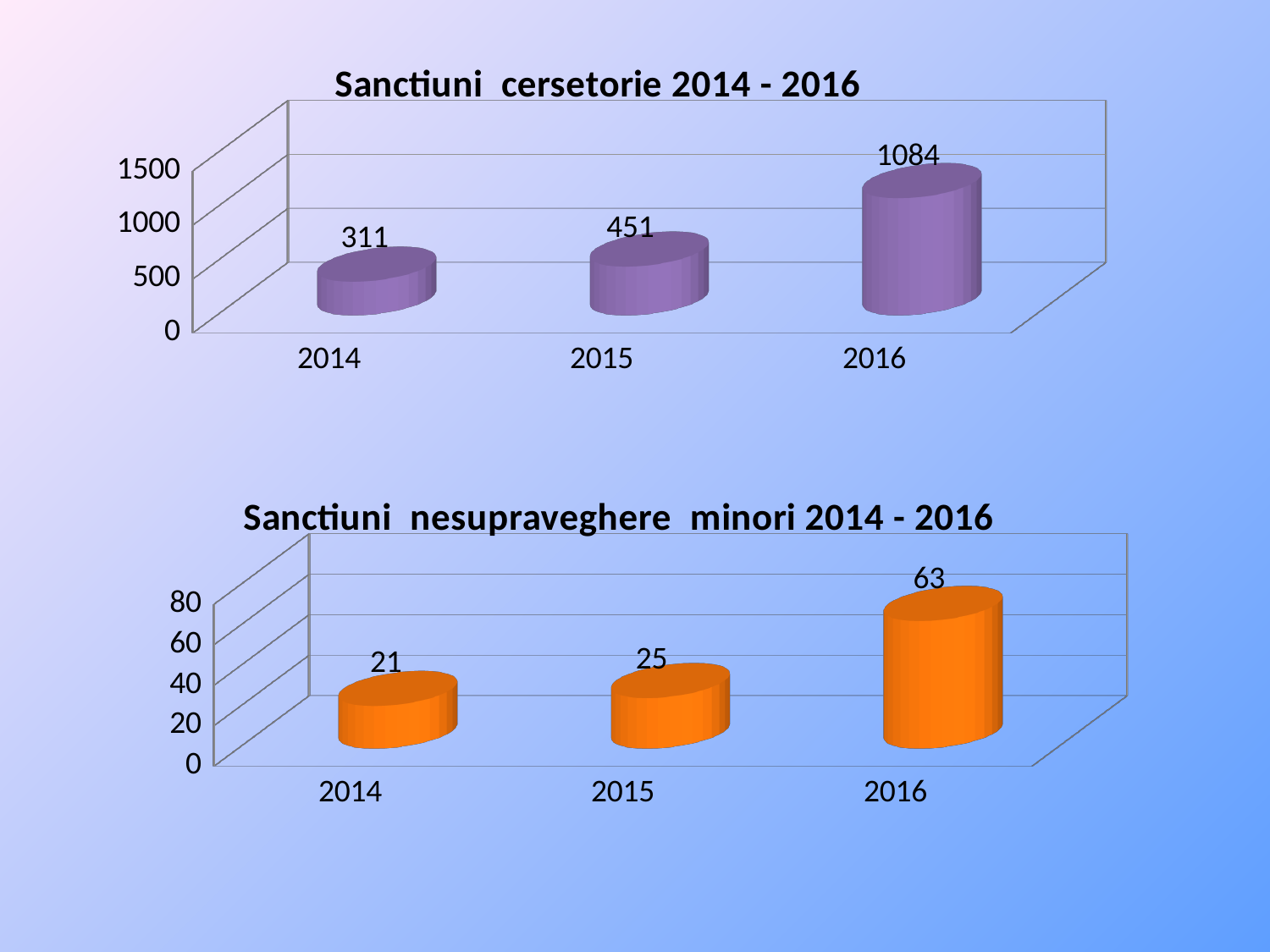
In the chart titled "Sanctiuni cersetorie 2014 - 2016", what is the difference between the values for 2016 and 2015? 633 How many categories are shown on the x axis of the chart titled "Sanctiuni cersetorie 2014 - 2016"? 3 What kind of chart is the chart titled "Sanctiuni nesupraveghere minori 2014 - 2016"? bar chart In the chart titled "Sanctiuni nesupraveghere minori 2014 - 2016", what is the value for 2015? 25 In the chart titled "Sanctiuni cersetorie 2014 - 2016", which year has the highest value? 2016 In the chart titled "Sanctiuni cersetorie 2014 - 2016", what is the value for 2016? 1084 In the chart titled "Sanctiuni nesupraveghere minori 2014 - 2016", what is the value for 2016? 63 In the chart titled "Sanctiuni nesupraveghere minori 2014 - 2016", what is the difference between the values for 2016 and 2014? 42 In the chart titled "Sanctiuni cersetorie 2014 - 2016", what is the value for 2014? 311 In the chart titled "Sanctiuni cersetorie 2014 - 2016", do the values rise or fall from 2014 to 2016? rise In the chart titled "Sanctiuni nesupraveghere minori 2014 - 2016", which is larger, the value for 2014 or the value for 2016? 2016 In the chart titled "Sanctiuni nesupraveghere minori 2014 - 2016", which year has the lowest value? 2014